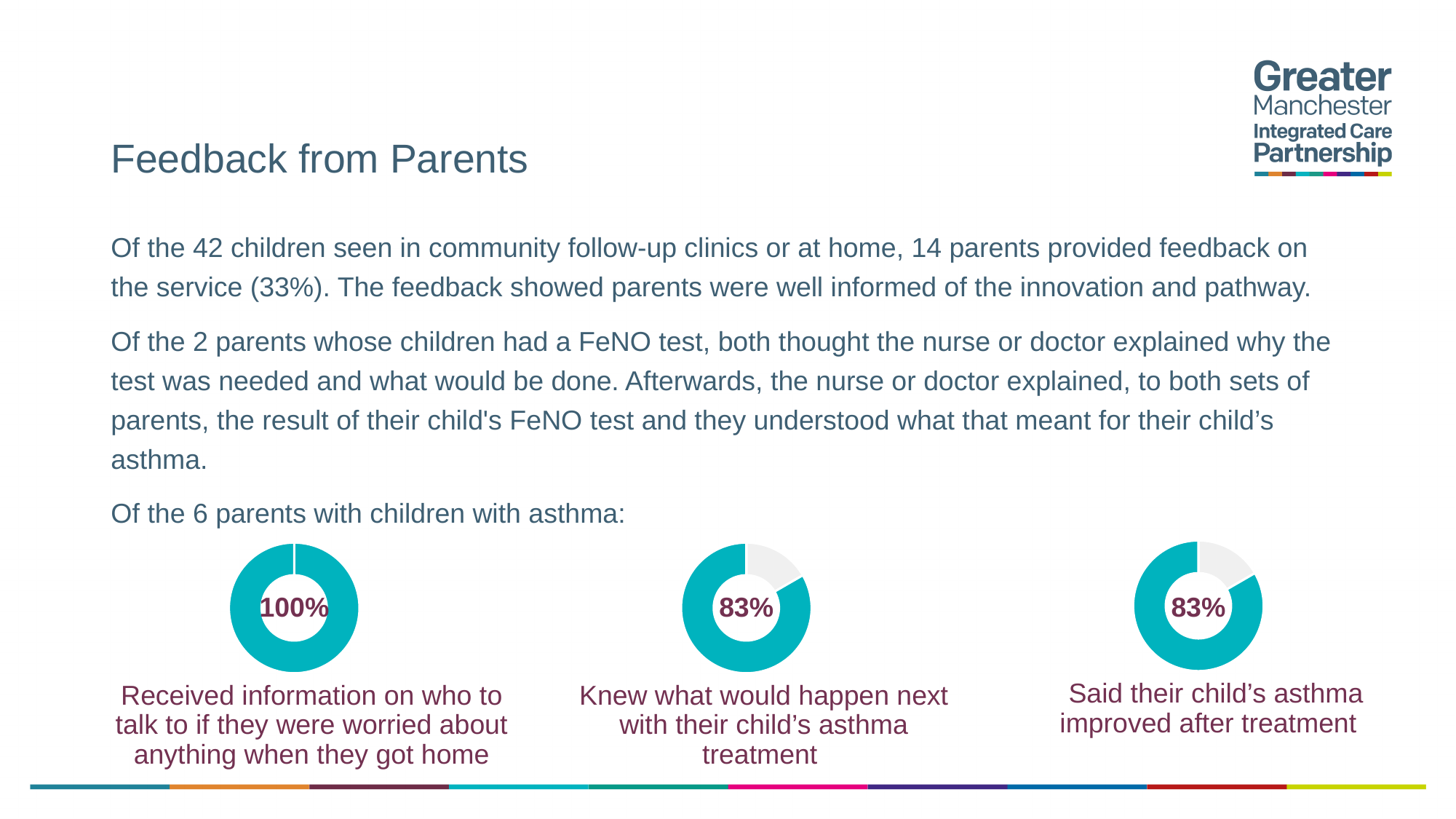
What is the difference between the percentage in the left donut chart (received information on who to talk to) and the percentage in the middle donut chart (knew what would happen next)? 17% What percentage is shown in the middle donut chart, for parents who knew what would happen next with their child's asthma treatment? 83% How many donut charts are shown on the slide? 3 Do the middle and right donut charts show the same percentage? Yes, both 83% Which of the three donut charts shows the highest percentage? Received information on who to talk to if they were worried about anything when they got home (100%) What colour is the filled portion of the donut charts? Teal What percentage is shown in the right donut chart, for parents who said their child's asthma improved after treatment? 83% What kind of chart is used to show each of the three percentages at the bottom of the slide? Donut chart Is the percentage in the left donut chart (received information on who to talk to) larger than the percentage in the right donut chart (child's asthma improved after treatment)? Yes, 100% vs 83% What percentage is shown in the left donut chart, for parents who received information on who to talk to if they were worried about anything when they got home? 100% How many parents with children with asthma do the three donut charts refer to? 6